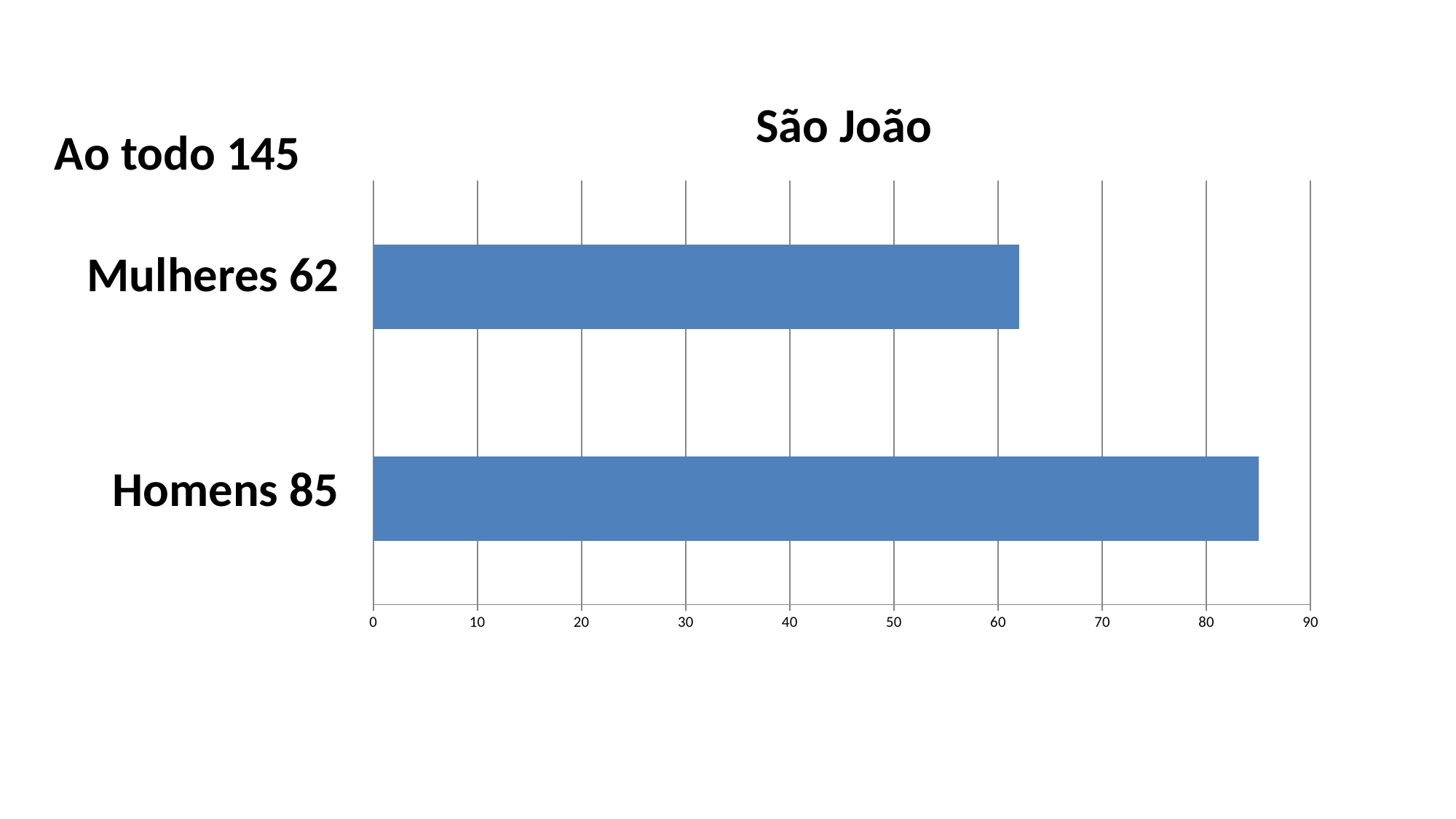
What kind of chart is shown on the slide? bar chart Which category has the lowest value in the São João chart? Mulheres Is the value for Homens in the São João chart greater or less than 80? greater What is the value for Mulheres in the São João chart? 62 Which is larger in the São João chart, the value for Homens or the value for Mulheres? Homens How many categories are shown in the São João chart? 2 Is the value for Mulheres in the São João chart greater or less than 70? less What is the value for Homens in the São João chart? 85 What is the difference between the values for Homens and Mulheres in the São João chart? 23 What is the title of the chart on the slide? São João Which category has the highest value in the São João chart? Homens What is the total of the two values shown in the São João chart? 147